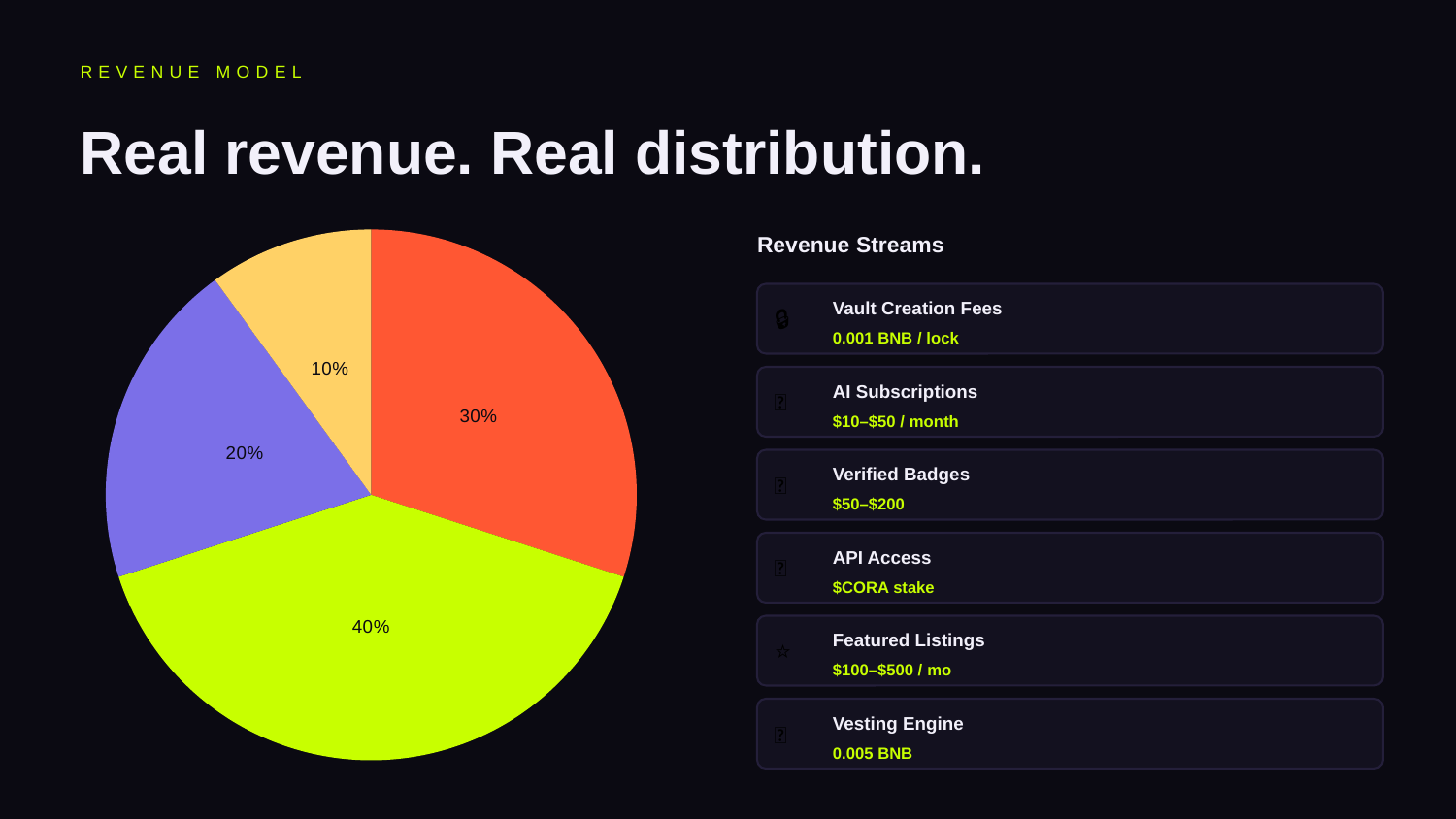
Which is larger in the pie chart, the purple slice or the yellow slice? purple What percentage is shown on the purple slice of the pie chart? 20% How many slices does the pie chart have? 4 What percentage is shown on the yellow slice of the pie chart? 10% What percentage is shown on the orange slice of the pie chart? 30% Which colour slice is the largest in the pie chart? green What percentage is shown on the green slice of the pie chart? 40% What is the combined share of the purple and yellow slices in the pie chart? 30% What is the title of the list shown to the right of the pie chart? Revenue Streams Which colour slice is the smallest in the pie chart? yellow What kind of chart is shown on the slide? pie chart What is the difference between the green slice and the orange slice in the pie chart? 10%